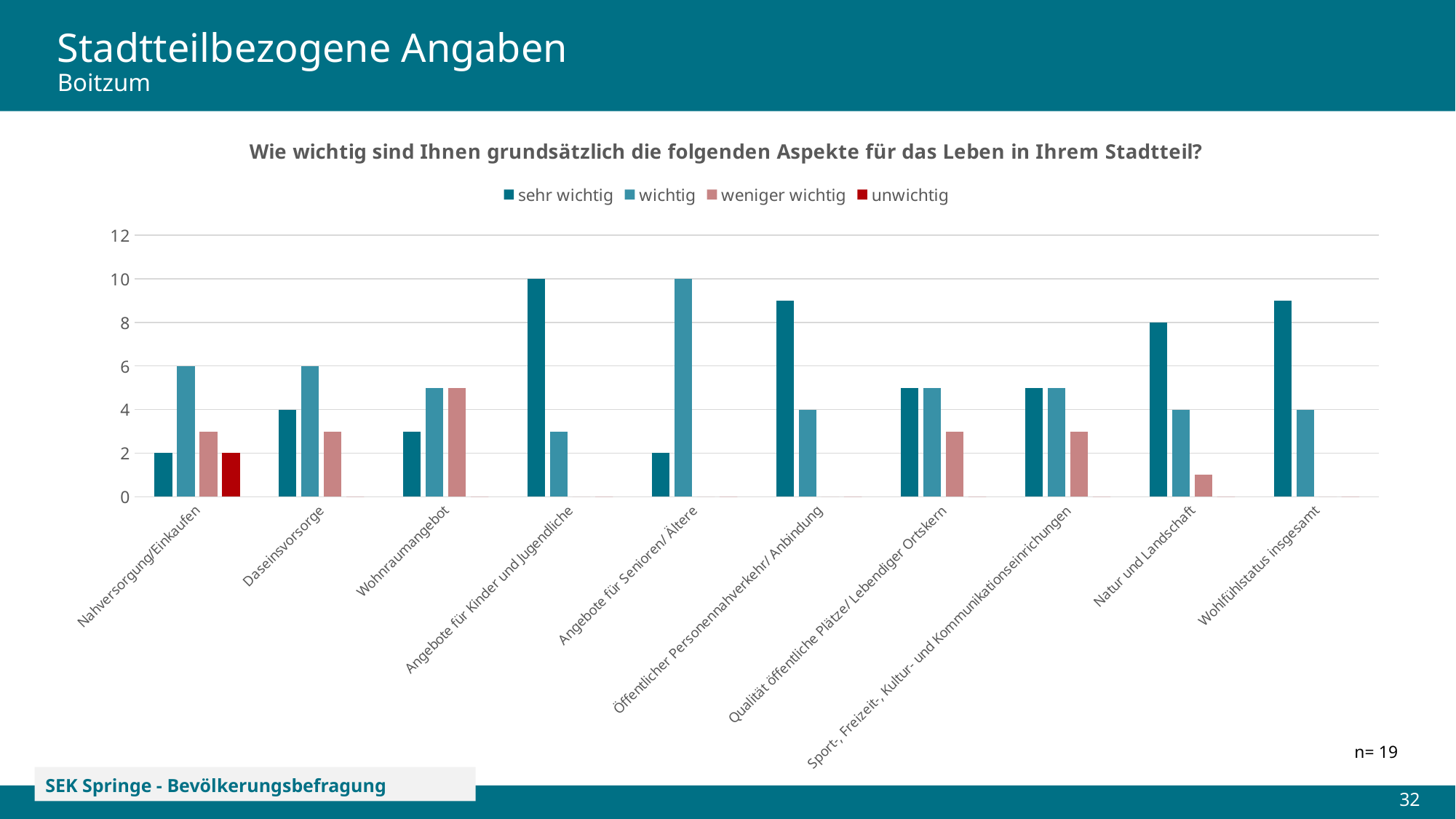
Which category has the highest 'wichtig' value? Angebote für Senioren/ Ältere What is the value of 'unwichtig' for 'Nahversorgung/Einkaufen'? 2 What is the value of 'wichtig' for 'Daseinsvorsorge'? 6 What is the value of 'sehr wichtig' for 'Natur und Landschaft'? 8 Is the value of 'sehr wichtig' for 'Öffentlicher Personennahverkehr/ Anbindung' greater or less than 8? greater What is the difference between 'sehr wichtig' and 'wichtig' for 'Natur und Landschaft'? 4 How many series does the legend list? 4 Which is larger for 'Nahversorgung/Einkaufen': 'sehr wichtig' or 'wichtig'? wichtig How many categories are shown on the x axis? 10 What is the value of 'wichtig' for 'Angebote für Senioren/ Ältere'? 10 What is the value of 'sehr wichtig' for 'Angebote für Kinder und Jugendliche'? 10 What kind of chart is shown on the slide? bar chart